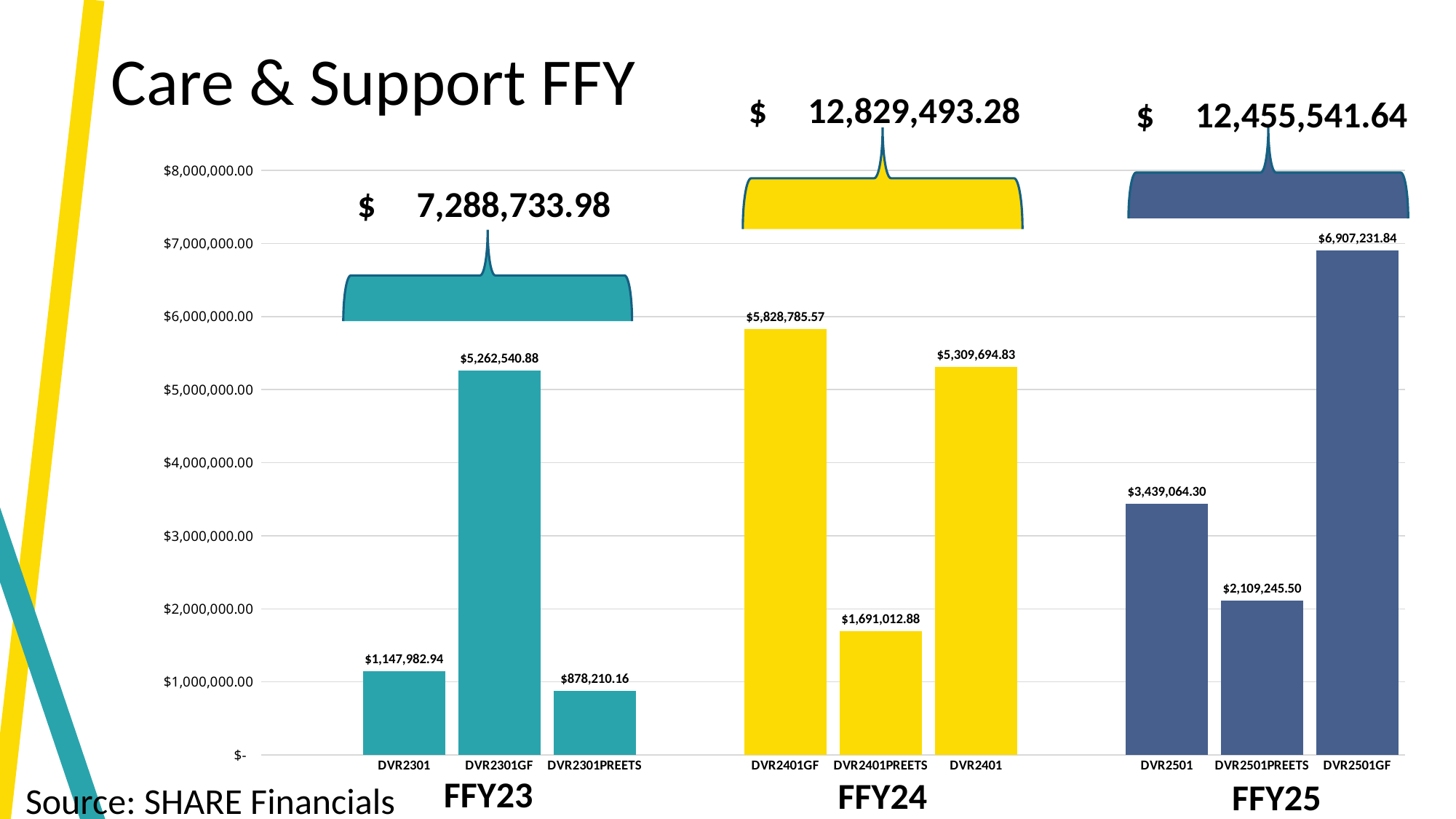
What is the value for DVR2401PREETS? $1,691,012.88 How many bars are plotted in the chart? 9 What is the total shown for FFY24? $12,829,493.28 Is the value for DVR2501PREETS greater or less than $2,000,000.00? greater What is the difference between DVR2501GF and DVR2401GF? $1,078,446.27 Which category has the lowest value? DVR2301PREETS What kind of chart is shown on the slide? bar chart Which is larger, DVR2401GF or DVR2401? DVR2401GF Do the GF values (DVR2301GF, DVR2401GF, DVR2501GF) rise or fall from FFY23 to FFY25? rise What is the value for DVR2301GF? $5,262,540.88 What is the value for DVR2501? $3,439,064.30 Which category has the highest value? DVR2501GF